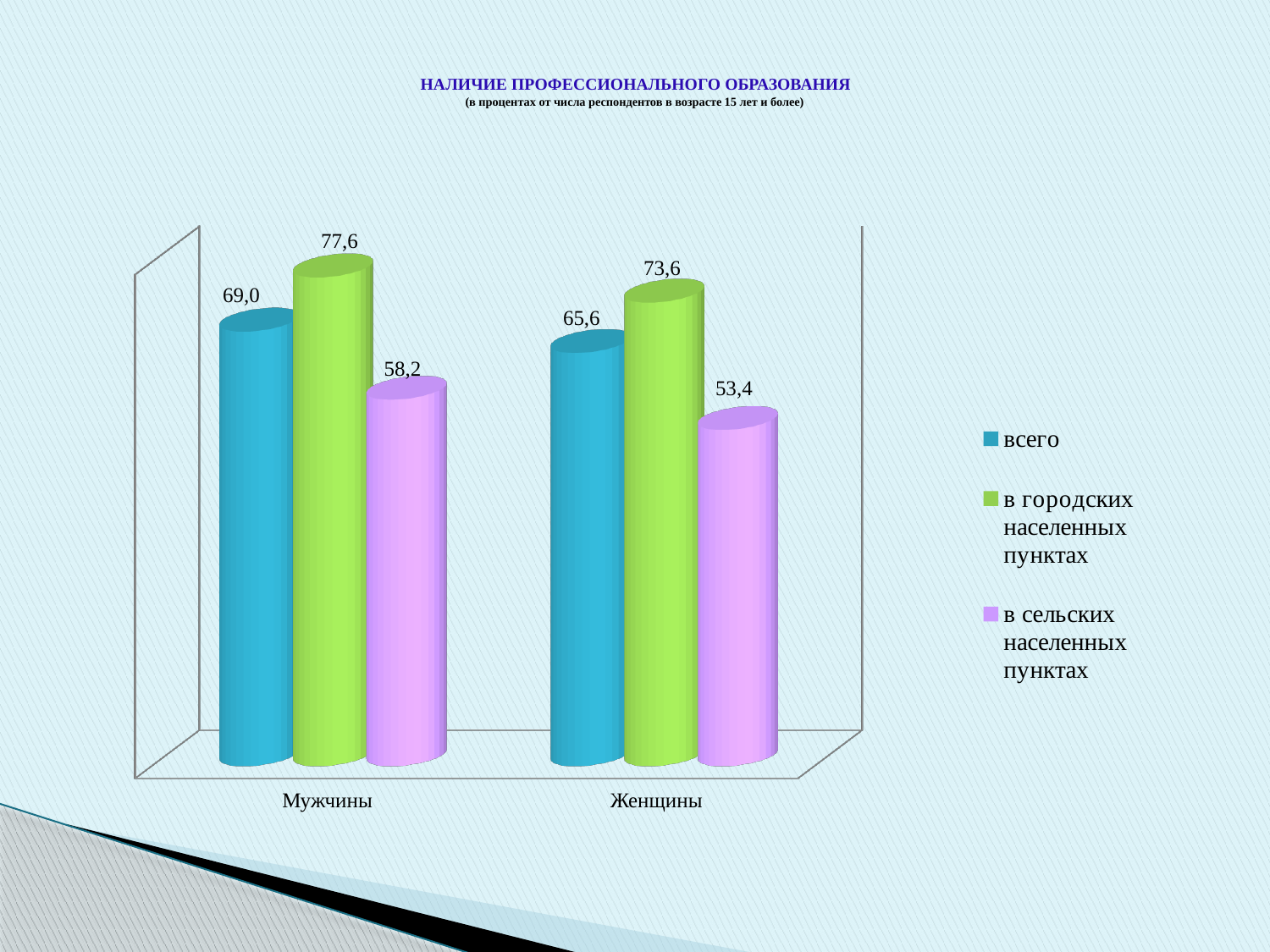
What is the difference between the "в городских населенных пунктах" and "в сельских населенных пунктах" values for Мужчины? 19,4 How many series does the legend list? 3 What is the value for "в сельских населенных пунктах" for Мужчины? 58,2 How many categories are shown on the x axis? 2 What is the difference between the "всего" values for Мужчины and Женщины? 3,4 Which series has the lowest value for Мужчины? в сельских населенных пунктах Which is larger: the "в сельских населенных пунктах" value for Мужчины or for Женщины? Мужчины What is the value for "всего" for Женщины? 65,6 What is the value for "в городских населенных пунктах" for Женщины? 73,6 What is the value for "всего" for Мужчины? 69,0 What kind of chart is shown on the slide? Bar chart Which series has the highest value for Женщины? в городских населенных пунктах